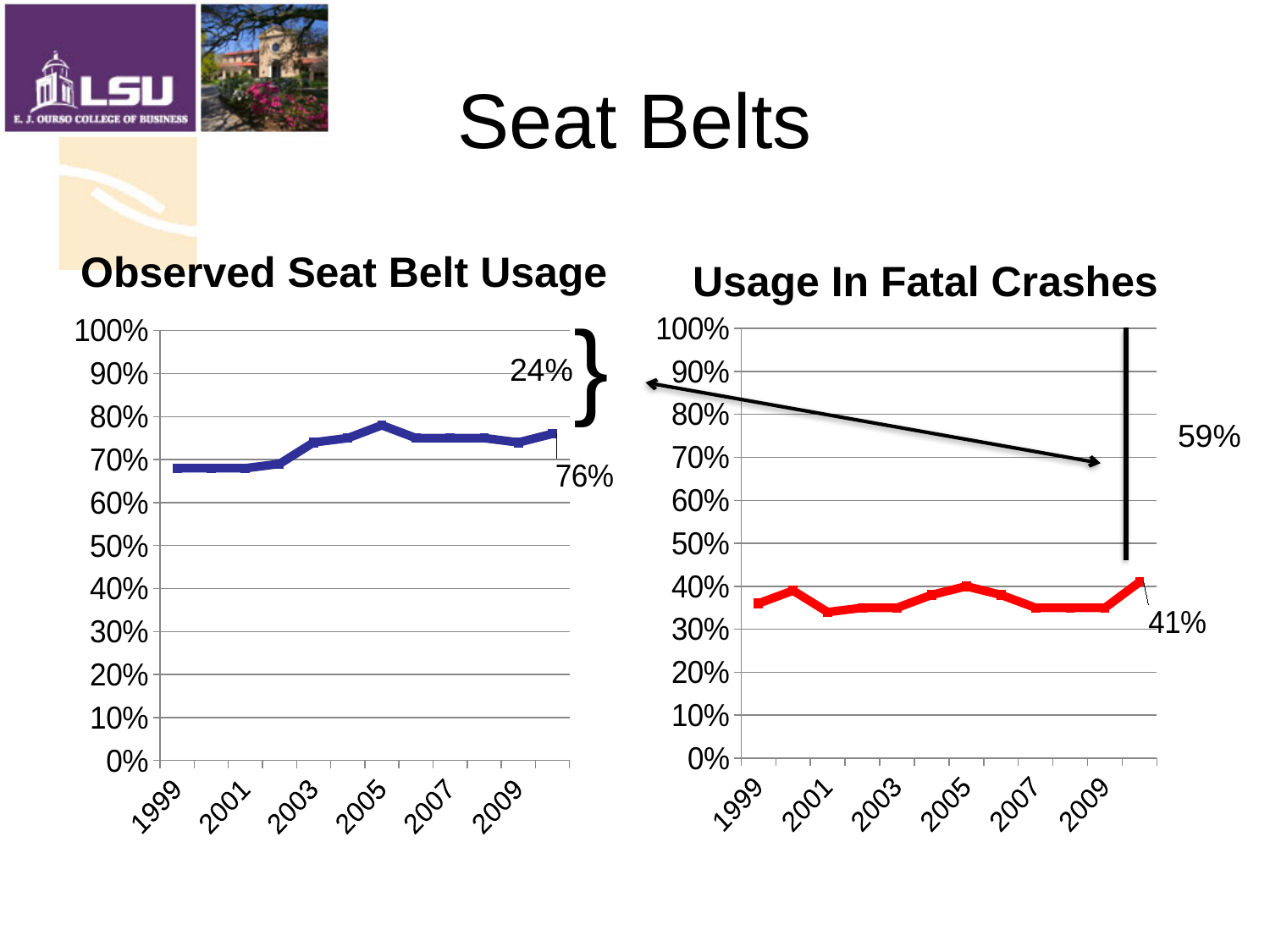
In the "Usage In Fatal Crashes" chart, is the value for 2001 greater or less than 40%? less In the "Usage In Fatal Crashes" chart, is the value for 1999 greater or less than 50%? less What kind of chart is the "Observed Seat Belt Usage" chart? line chart What colour is the line in the "Usage In Fatal Crashes" chart? red In the "Observed Seat Belt Usage" chart, is the value for 2005 greater or less than 70%? greater In the "Observed Seat Belt Usage" chart, does the line generally rise or fall from 1999 to 2010? rise In the "Usage In Fatal Crashes" chart, what is the labeled value at the end of the line (2010)? 41% In the "Observed Seat Belt Usage" chart, what is the labeled value at the end of the line (2010)? 76% What kind of chart is the "Usage In Fatal Crashes" chart? line chart What is the difference between the final labeled value in the "Observed Seat Belt Usage" chart (76%) and the final labeled value in the "Usage In Fatal Crashes" chart (41%)? 35% Which is larger: the final labeled value in the "Observed Seat Belt Usage" chart or the final labeled value in the "Usage In Fatal Crashes" chart? Observed Seat Belt Usage (76%)